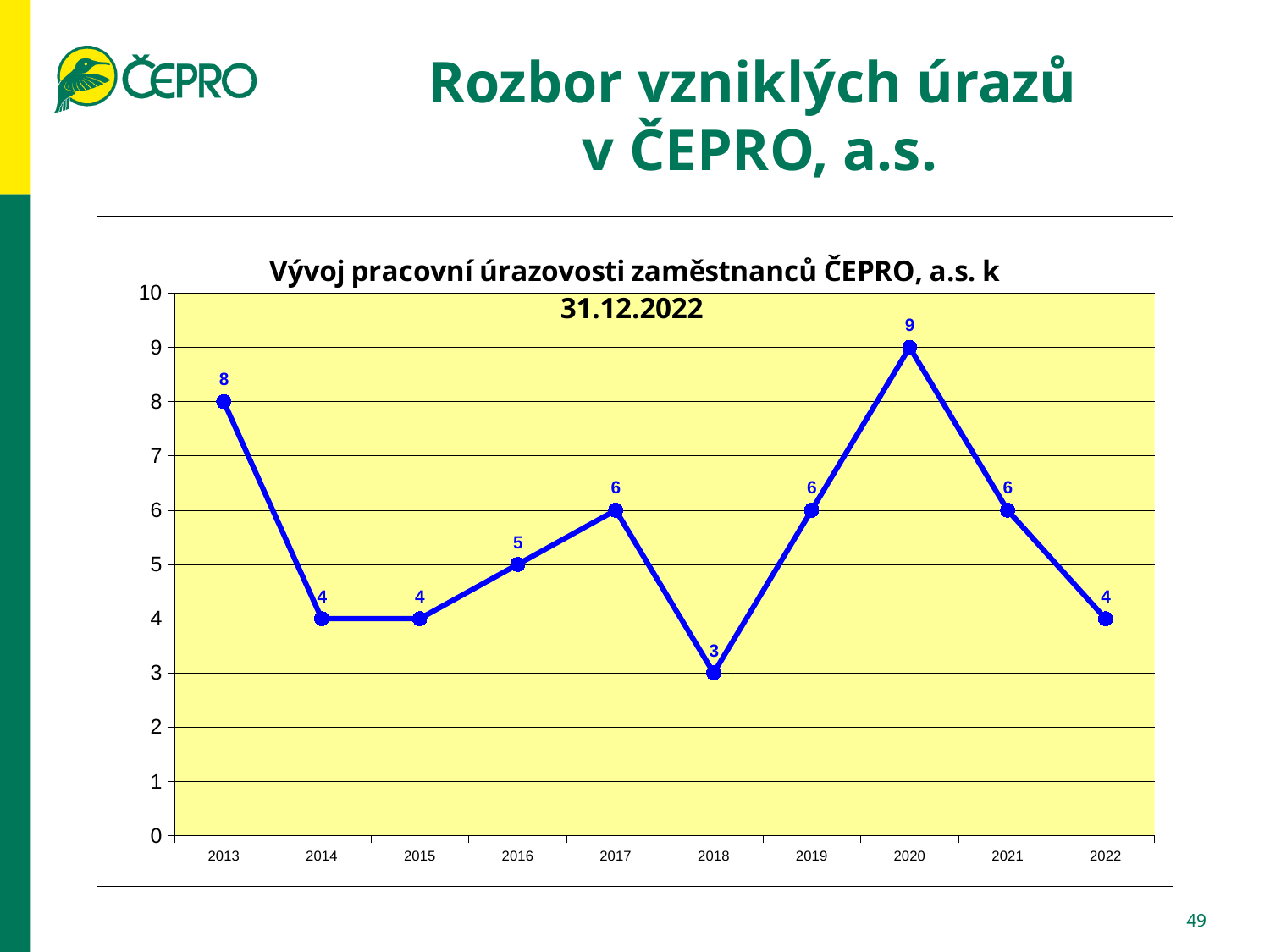
Which year has the highest value? 2020 What is the difference between the values for 2020 and 2018? 6 Is the value for 2020 greater or less than 5? greater Which is larger, the value for 2013 or the value for 2017? 2013 What is the title of the chart? Vývoj pracovní úrazovosti zaměstnanců ČEPRO, a.s. k 31.12.2022 What kind of chart is shown? line chart What is the value for 2013? 8 What is the value for 2022? 4 What is the value for 2018? 3 Which year has the lowest value? 2018 Do the values rise or fall from 2020 to 2022? fall How many years are plotted on the x axis? 10